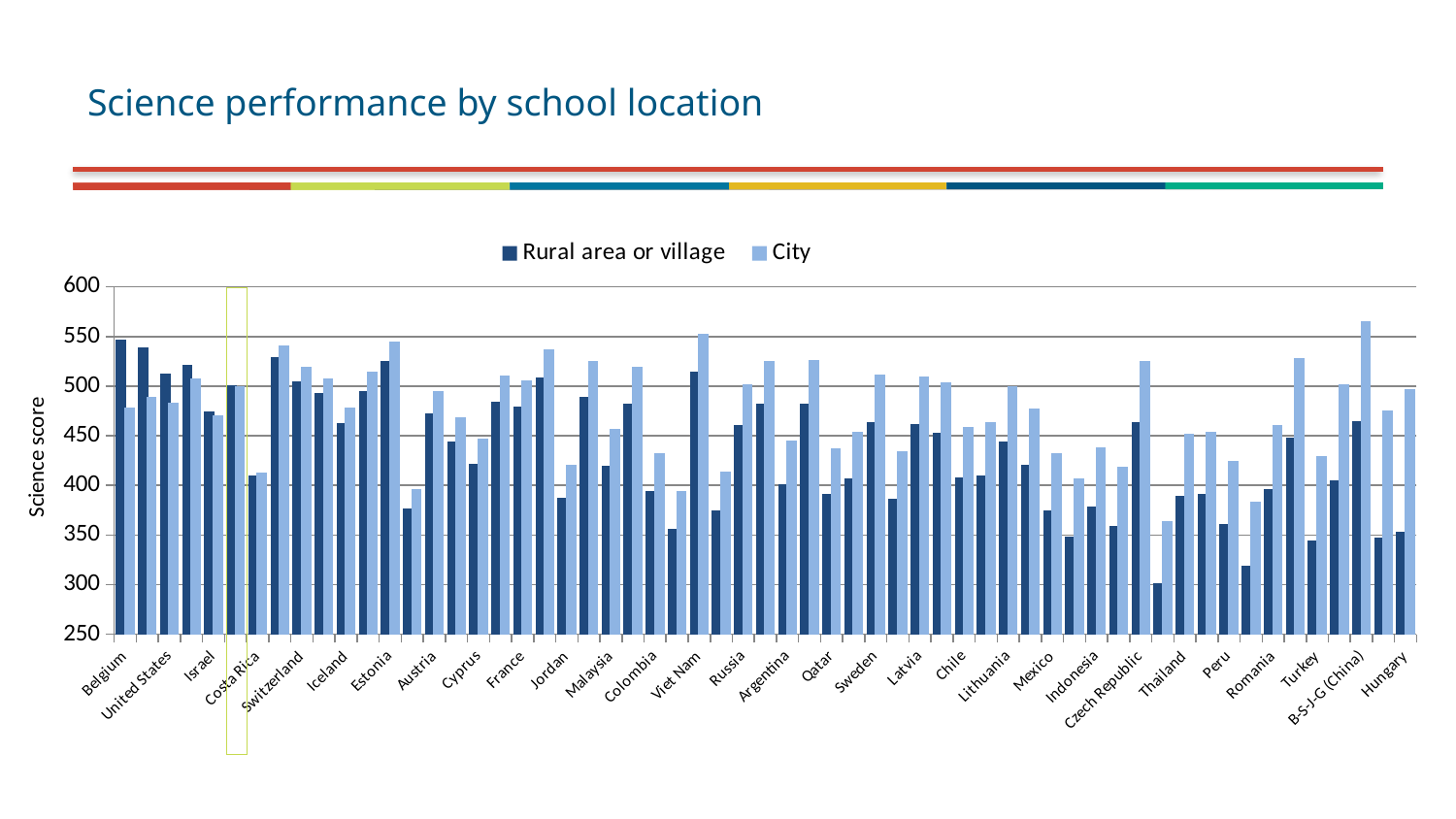
Is the Rural area or village value for Hungary greater or less than 400? less Is the City value for B-S-J-G (China) greater or less than 550? greater For B-S-J-G (China), which is larger: the Rural area or village value or the City value? City What is the title of the chart? Science performance by school location What are the two series named in the legend? Rural area or village; City What kind of chart is shown on the slide? Bar chart For Belgium, which is larger: the Rural area or village value or the City value? Rural area or village For Hungary, which is larger: the Rural area or village value or the City value? City How many series does the legend list? 2 Is the Rural area or village value for Belgium greater or less than 500? greater